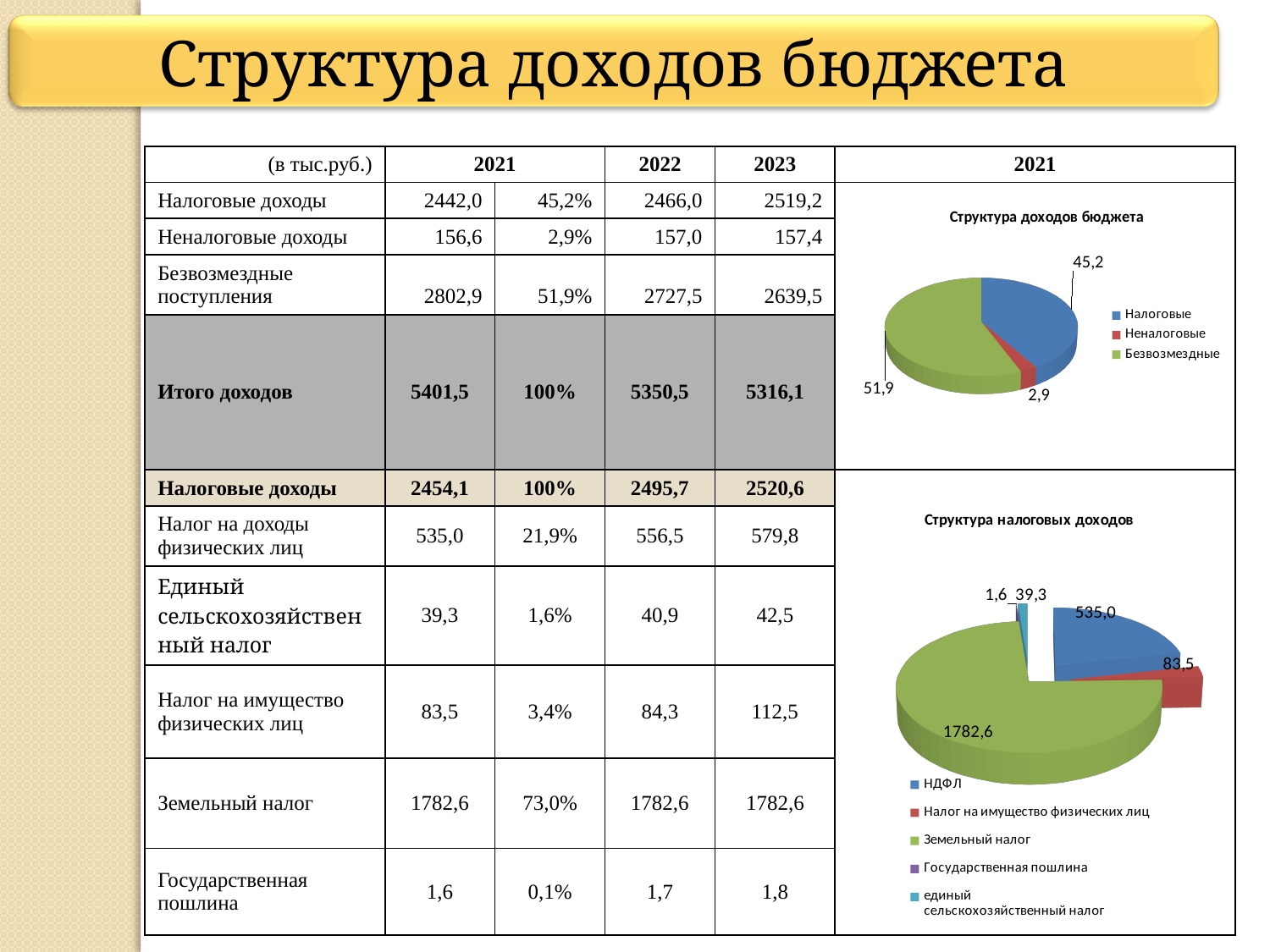
In the chart "Структура доходов бюджета", what is the value shown for Неналоговые? 2,9 In the chart "Структура налоговых доходов", what is the value shown for Земельный налог? 1782,6 In the chart "Структура налоговых доходов", what is the value shown for НДФЛ? 535,0 How many categories does the legend of the chart "Структура налоговых доходов" list? 5 What type of chart is the chart titled "Структура доходов бюджета"? pie chart In the chart "Структура налоговых доходов", which category has the smallest value? Государственная пошлина In the chart "Структура доходов бюджета", what is the value shown for Налоговые? 45,2 In the chart "Структура доходов бюджета", which category has the smallest slice? Неналоговые In the chart "Структура налоговых доходов", which is larger: Налог на имущество физических лиц or единый сельскохозяйственный налог? Налог на имущество физических лиц In the chart "Структура доходов бюджета", what is the difference between the values for Безвозмездные and Налоговые? 6,7 How many categories does the legend of the chart "Структура доходов бюджета" list? 3 In the chart "Структура доходов бюджета", which category has the largest slice? Безвозмездные